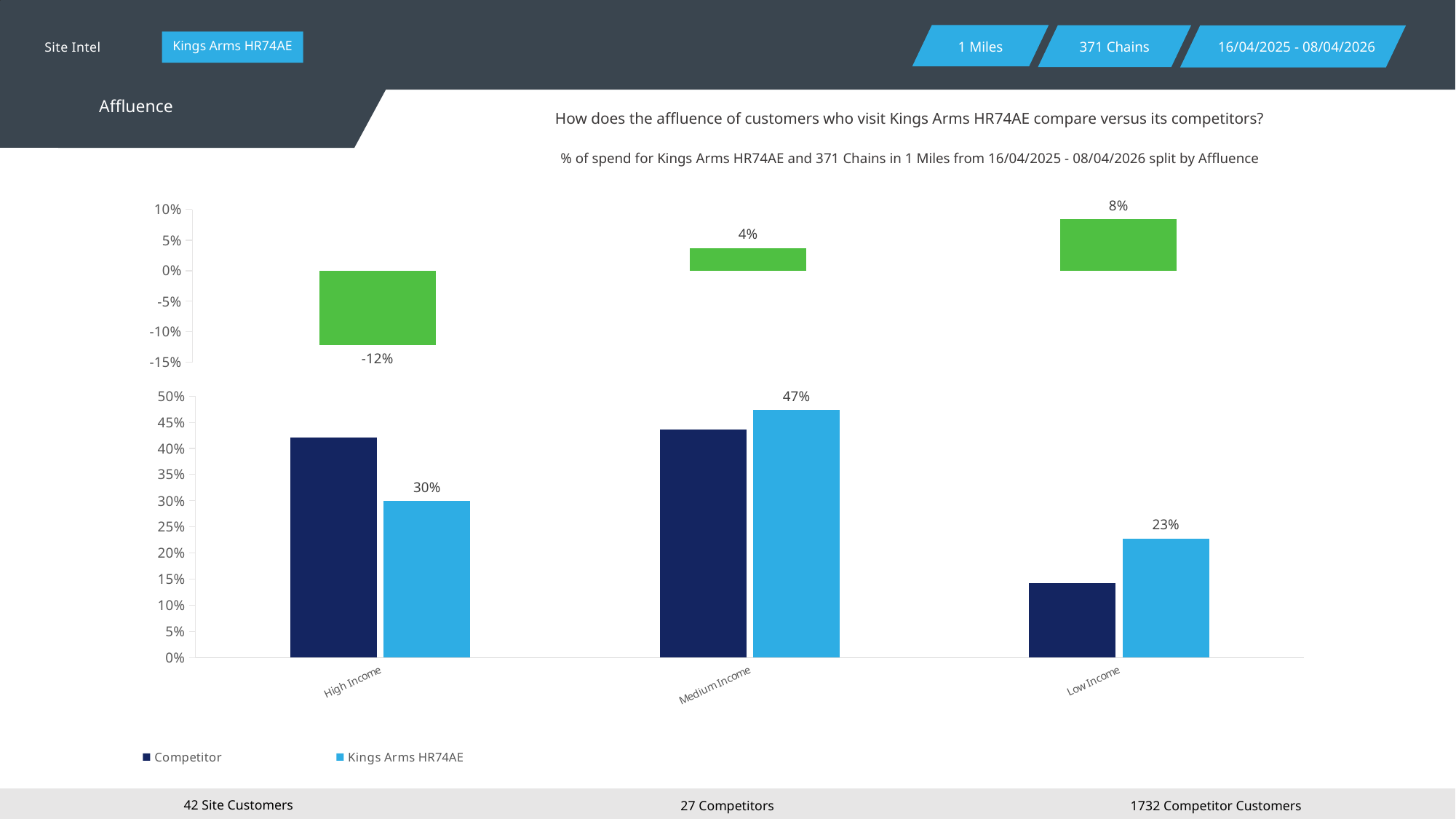
How many series does the legend of the bottom chart list? 2 In the bottom chart, what is the difference between the Kings Arms HR74AE values for Medium Income and Low Income? 24% In the bottom chart, which category has the highest value for Kings Arms HR74AE? Medium Income In the bottom chart, is the Competitor value for High Income greater or less than 40%? greater In the bottom chart, is the Competitor value for Low Income greater or less than 20%? less In the bottom chart, what is the value for Kings Arms HR74AE in the Medium Income category? 47% In the bottom chart, what is the value for Kings Arms HR74AE in the Low Income category? 23% In the top chart, what is the value shown for the Low Income category? 8% In the top chart, what is the value shown for the High Income category? -12% In the bottom chart, which is larger for High Income: the Competitor value or the Kings Arms HR74AE value? Competitor In the top chart, which category has the lowest value? High Income In the bottom chart, what is the value for Kings Arms HR74AE in the High Income category? 30%